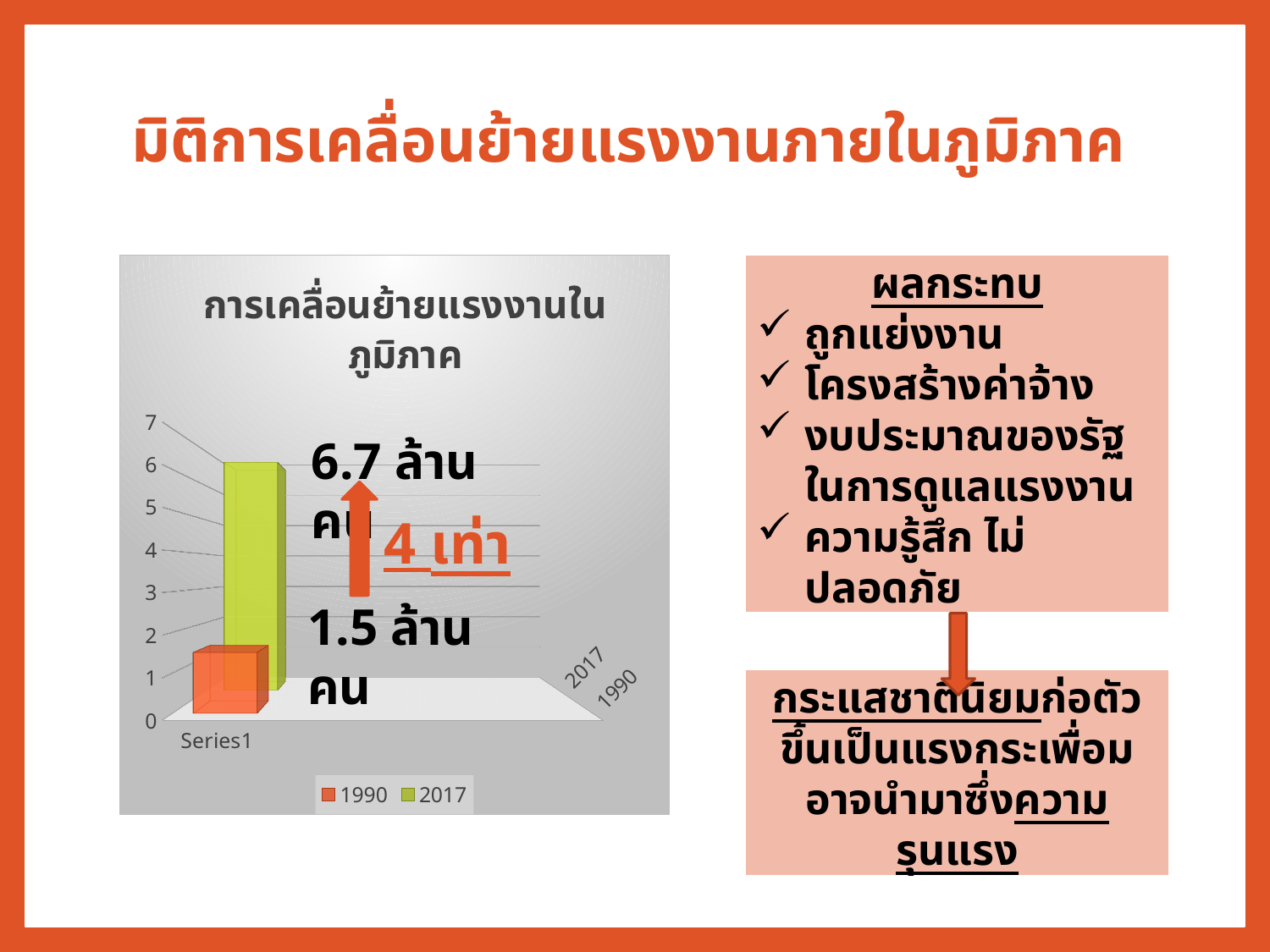
Which series has the taller bar, 1990 or 2017? 2017 Is the value for 1990 greater or less than 2? less Is the value for 2017 greater or less than 5? greater According to the label printed on the chart, what is the labour migration figure for 2017? 6.7 ล้านคน Is the bar for 2017 larger or smaller than the bar for 1990? larger What kind of chart is shown on the slide? bar chart Which series has the shorter bar in the chart? 1990 How many series does the chart legend list? 2 What is the highest value shown on the chart's vertical axis? 7 Which two years are listed in the chart legend? 1990 and 2017 What is the title of the chart? การเคลื่อนย้ายแรงงานในภูมิภาค According to the label printed on the chart, what is the labour migration figure for 1990? 1.5 ล้านคน